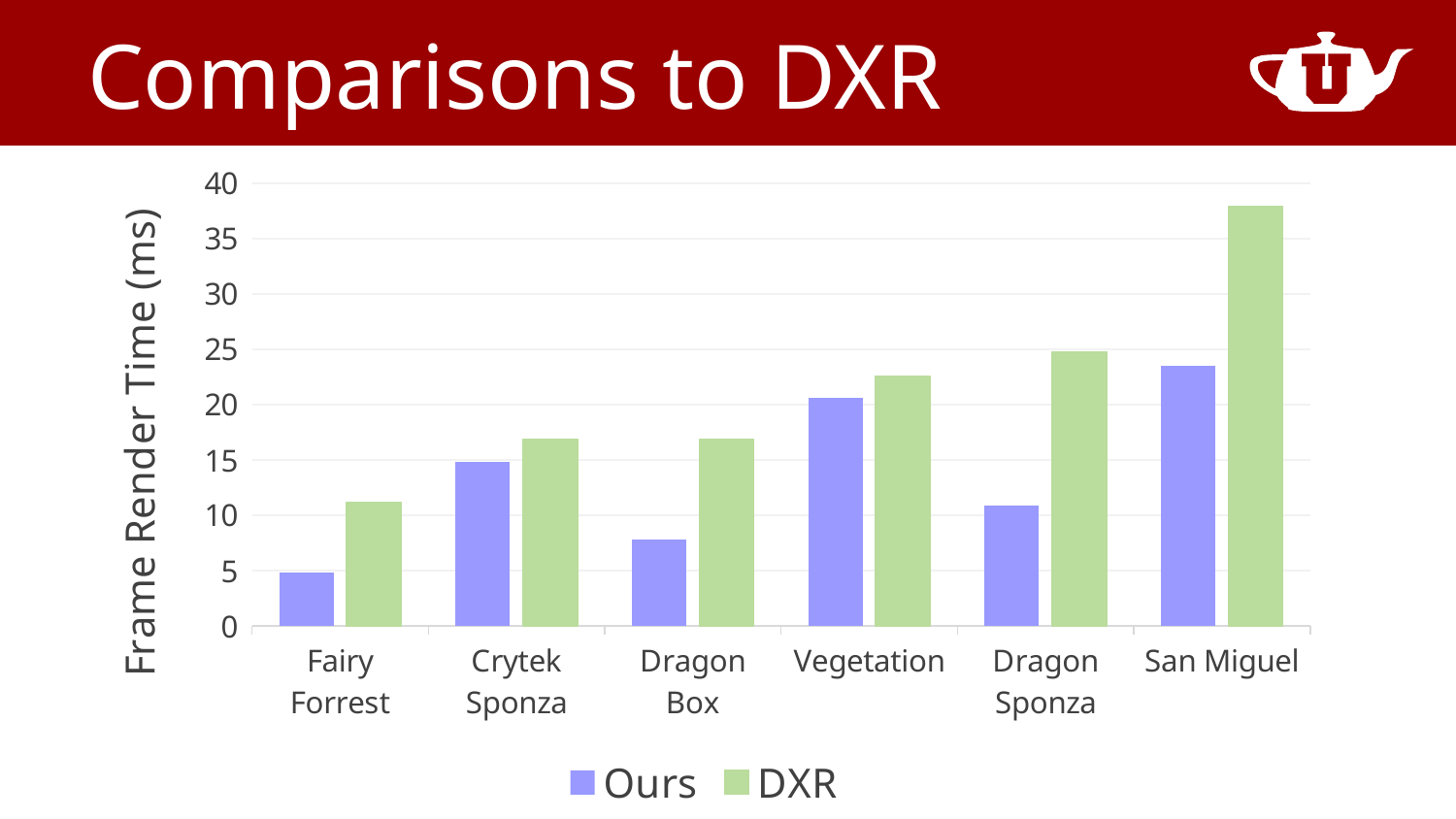
Is the value for Ours on Dragon Box greater or less than 10? less For Dragon Sponza, which is larger: the Ours value or the DXR value? DXR Which scene has the lowest frame render time for Ours? Fairy Forrest Which is larger: the Ours value for San Miguel or the Ours value for Vegetation? San Miguel How many series does the legend list? 2 Is the DXR value for Dragon Sponza greater or less than 20? greater How many scenes (categories) are shown on the x axis? 6 Is the DXR value for San Miguel greater or less than 35? greater Which scene has the highest DXR frame render time? San Miguel What is the label of the y axis? Frame Render Time (ms) What kind of chart is shown on the slide? bar chart Which scene has the lowest DXR frame render time? Fairy Forrest